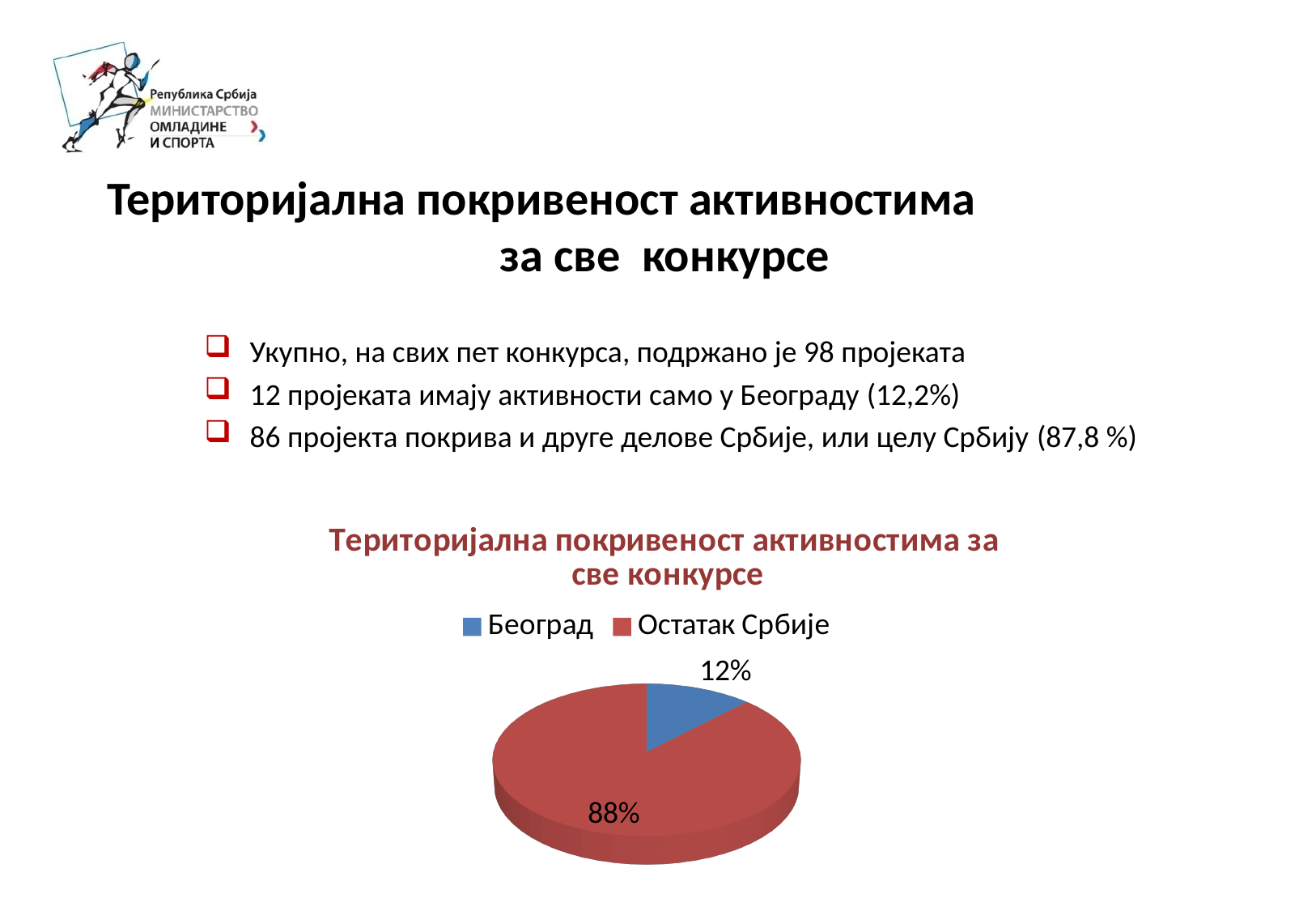
Which slice of the pie is the smallest? Београд How many slices does the pie chart have? 2 How many entries does the legend list? 2 What is the difference in percentage points between the Остатак Србије slice and the Београд slice? 76% What is the title of the chart? Територијална покривеност активностима за све конкурсе What share of the pie does Остатак Србије have? 88% Which is larger, the slice for Београд or the slice for Остатак Србије? Остатак Србије What colour is the slice for Београд? blue Which slice of the pie is the largest? Остатак Србије What kind of chart is shown on the slide? pie chart What share of the pie does Београд have? 12%